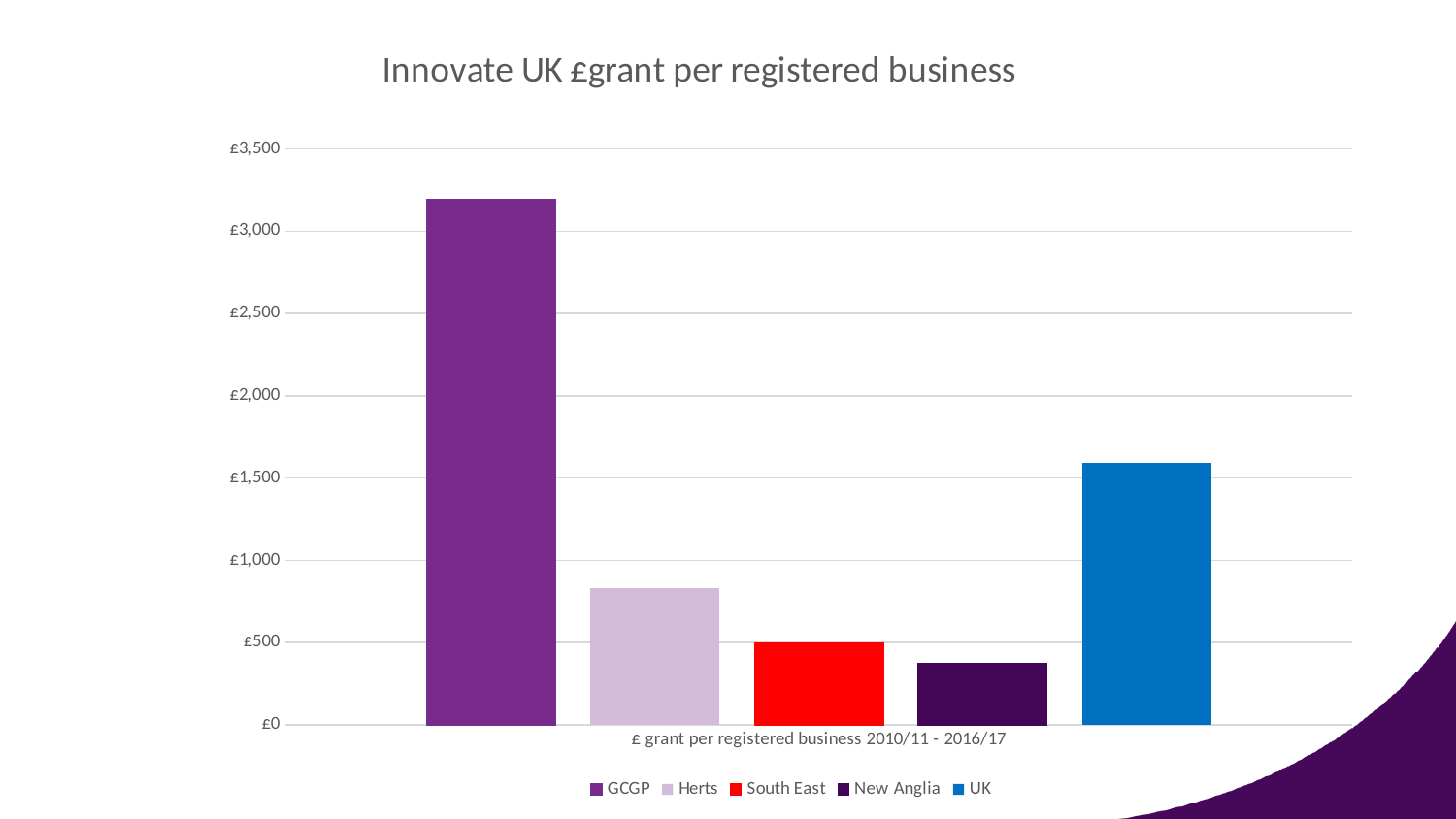
Which region has the highest £ grant per registered business? GCGP Is the value for GCGP greater or less than £3,000? greater What is the title of the chart? Innovate UK £grant per registered business Which region has the lowest £ grant per registered business? New Anglia How many series does the legend list? 5 What kind of chart is shown on the slide? Bar chart How many bars are plotted in the chart? 5 What is the label shown beneath the bars on the horizontal axis? £ grant per registered business 2010/11 - 2016/17 Is the value for UK greater or less than £1,000? greater Is the value for Herts greater or less than £1,000? less Which is larger, the value for UK or the value for Herts? UK